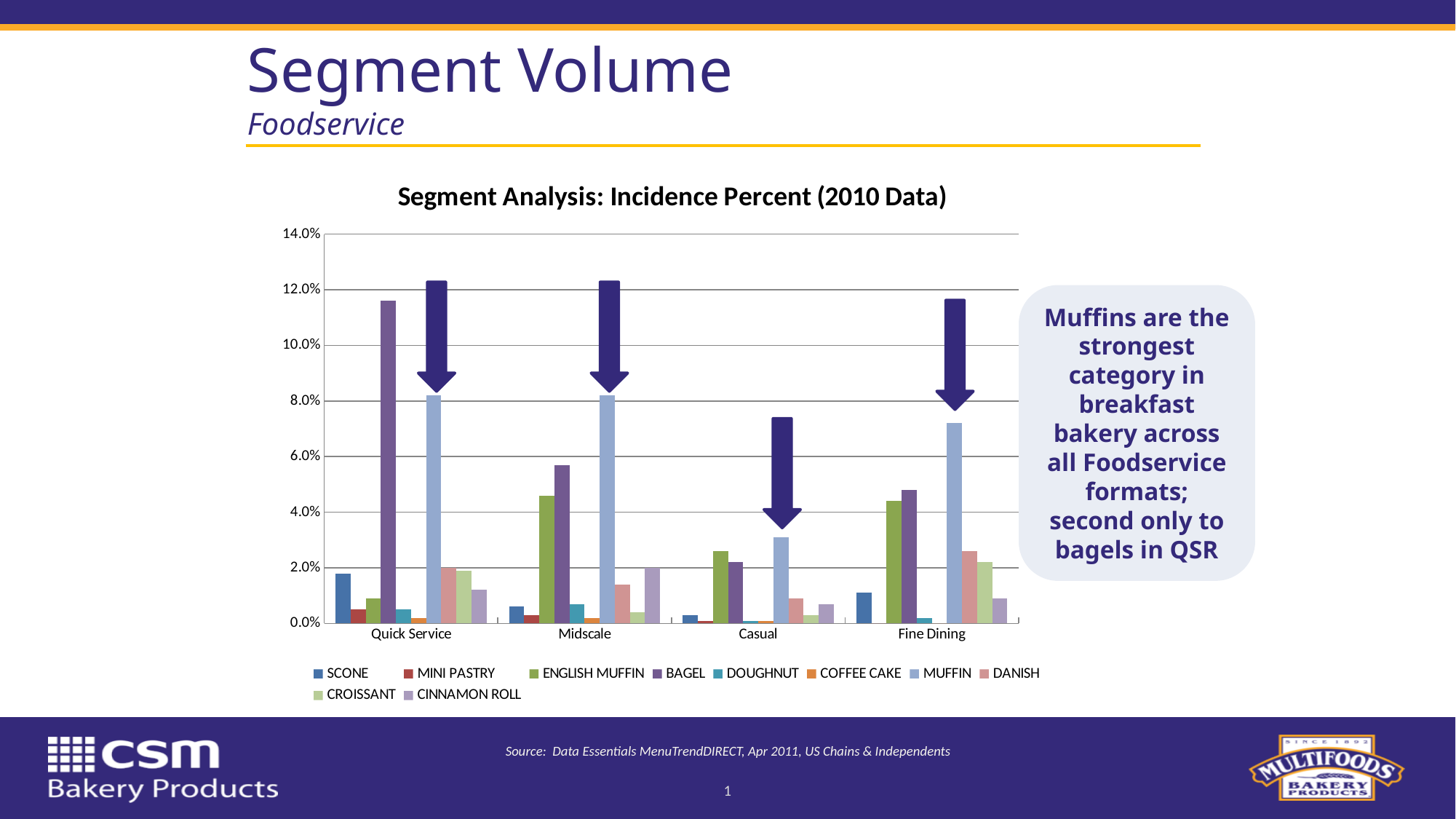
What is the title of the chart? Segment Analysis: Incidence Percent (2010 Data) How many foodservice segments are shown along the x axis of the chart? 4 What kind of chart is shown on the slide? bar chart In the Quick Service segment, which is larger: BAGEL or MUFFIN? BAGEL Is the value for BAGEL in Quick Service greater or less than 10.0%? greater How many series does the chart's legend list? 10 Is the value for MUFFIN in Midscale greater or less than 6.0%? greater Which product has the highest incidence percent in the Quick Service segment? BAGEL Is the value for MUFFIN in Casual greater or less than 4.0%? less Which product has the highest incidence percent in the Midscale segment? MUFFIN Which product has the highest incidence percent in the Fine Dining segment? MUFFIN